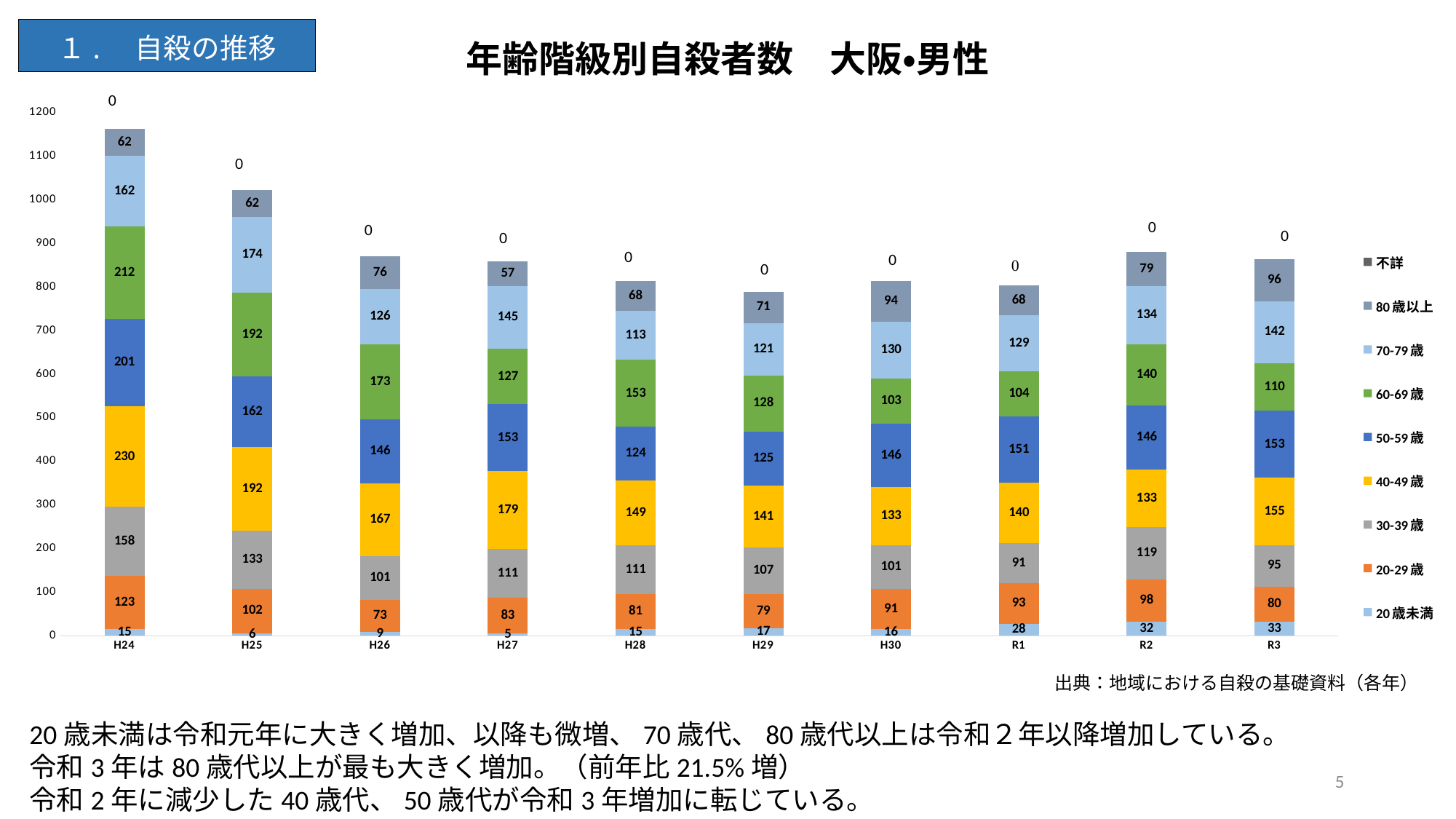
What type of chart is shown on the slide? Stacked bar chart What is the difference between the 40-49歳 values in R3 and R2? 22 What is the total of the stacked bar for R3? 864 How many years (categories) are shown on the x axis of the chart? 10 What is the value for the 40-49歳 series in H24? 230 How many series does the legend of the chart list? 9 In which year is the value for the 20歳未満 series highest? R3 What is the value for the 20歳未満 series in R1? 28 Which is larger, the 60-69歳 value in H24 or in H25? H24 In which year is the value for the 20歳未満 series lowest? H27 What is the value for the 80歳以上 series in R3? 96 What is the title of the chart? 年齢階級別自殺者数 大阪・男性